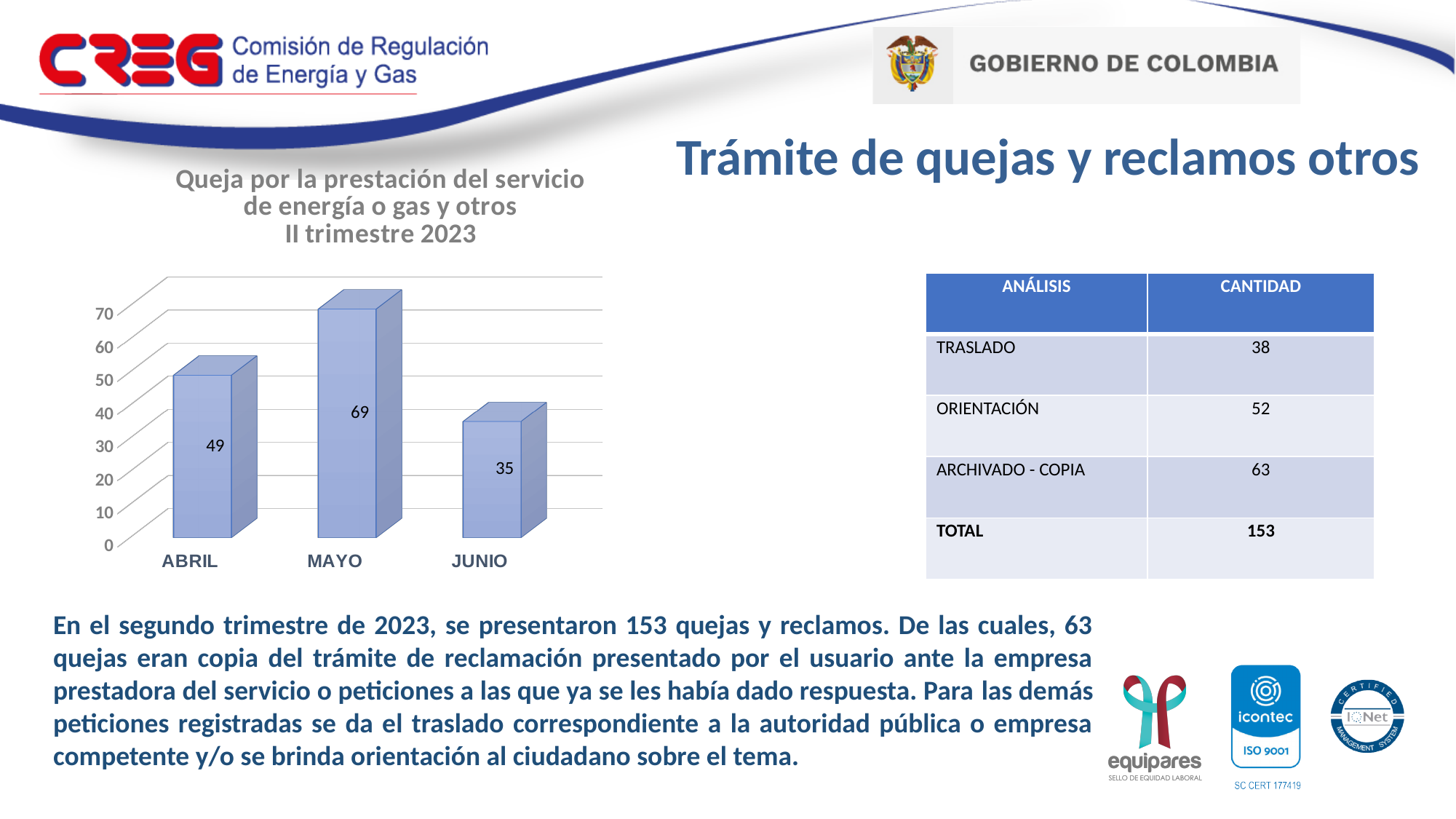
What is the title of the chart? Queja por la prestación del servicio de energía o gas y otros II trimestre 2023 How many months are shown in the chart? 3 What is the value for MAYO in the chart? 69 Which month has the lowest value in the chart? JUNIO Is the value for MAYO greater or less than 60? greater Which month has the highest value in the chart? MAYO What is the difference between the values for ABRIL and JUNIO? 14 What is the value for JUNIO in the chart? 35 What is the difference between the values for MAYO and ABRIL? 20 What kind of chart is shown on the slide? bar chart Which is larger, the value for ABRIL or the value for JUNIO? ABRIL What is the value for ABRIL in the chart? 49